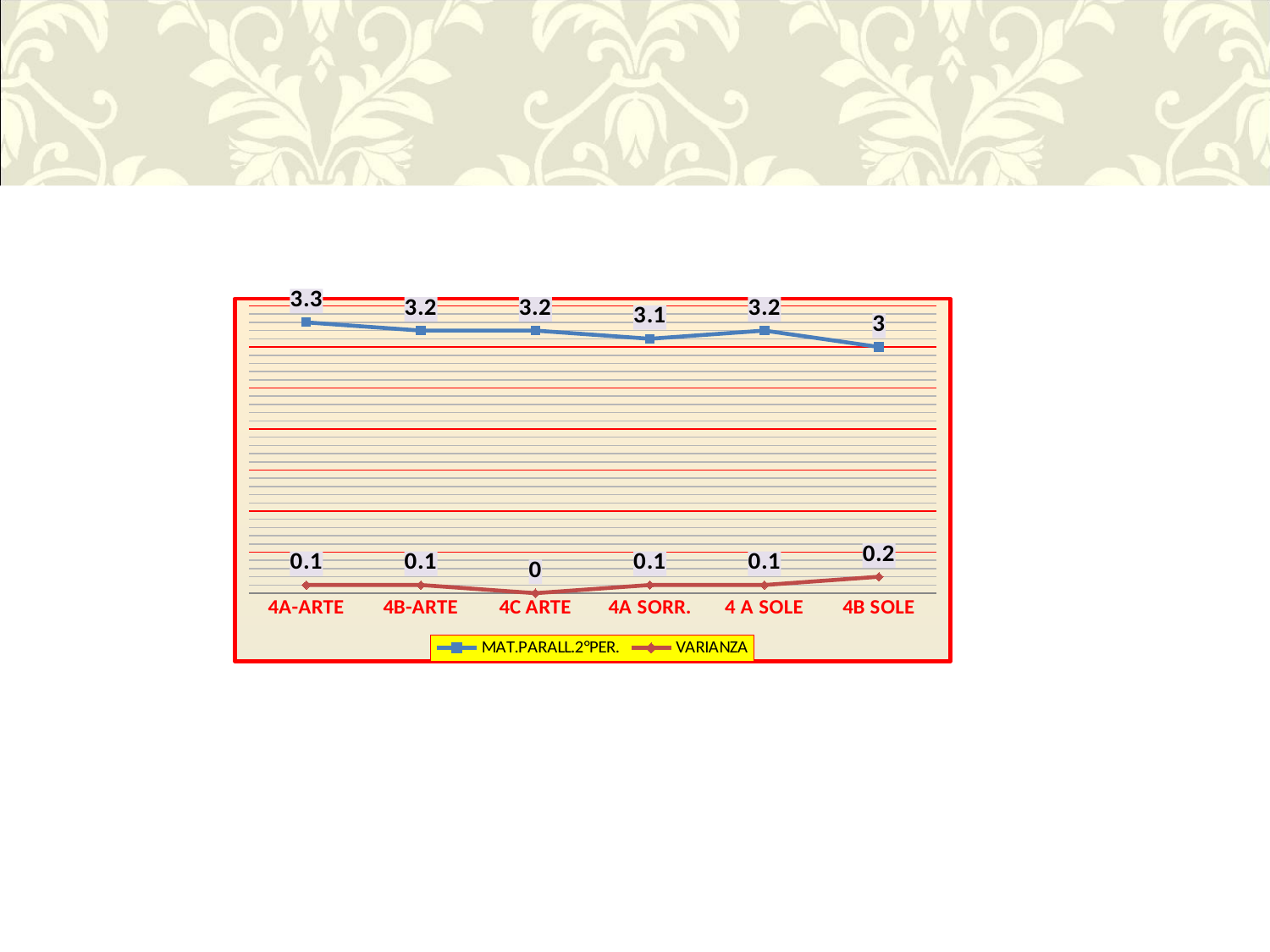
What is the MAT.PARALL.2°PER. value for 4A SORR.? 3.1 What is the difference between the MAT.PARALL.2°PER. values for 4A-ARTE and 4B SOLE? 0.3 Which category has the highest VARIANZA value? 4B SOLE How many series does the legend list? 2 How many categories are shown on the x axis? 6 What is the VARIANZA value for 4B SOLE? 0.2 What is the VARIANZA value for 4C ARTE? 0 Which category has the highest MAT.PARALL.2°PER. value? 4A-ARTE What is the MAT.PARALL.2°PER. value for 4A-ARTE? 3.3 Which is larger, the MAT.PARALL.2°PER. value for 4B-ARTE or for 4A SORR.? 4B-ARTE What kind of chart is this? Line chart Which category has the lowest MAT.PARALL.2°PER. value? 4B SOLE